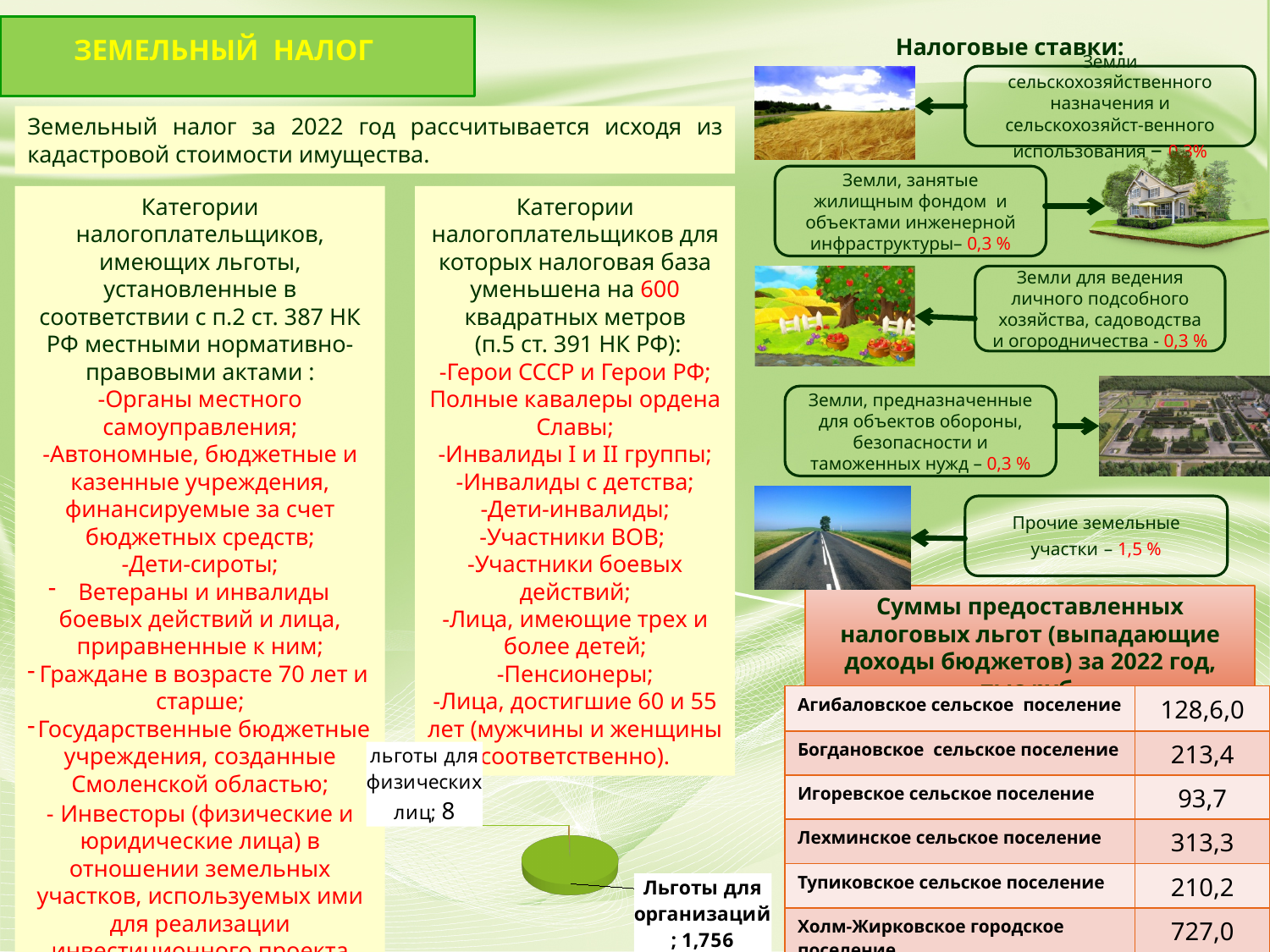
In the pie chart, what is the value for "Льготы для организаций"? 1,756 Is the value for "Льготы для организаций" in the pie chart greater or less than 1,000? greater In the pie chart, which is larger: "Льготы для организаций" or "льготы для физических лиц"? Льготы для организаций Which slice of the pie chart is the largest? Льготы для организаций What is the total of the two values shown in the pie chart? 1,764 What kind of chart is shown at the bottom of the slide? pie chart In the pie chart, what is the value for "льготы для физических лиц"? 8 Which slice of the pie chart is the smallest? льготы для физических лиц How many slices does the pie chart have? 2 What colour is the large slice of the pie chart? green In the pie chart, what is the difference between the value for "Льготы для организаций" and the value for "льготы для физических лиц"? 1,748